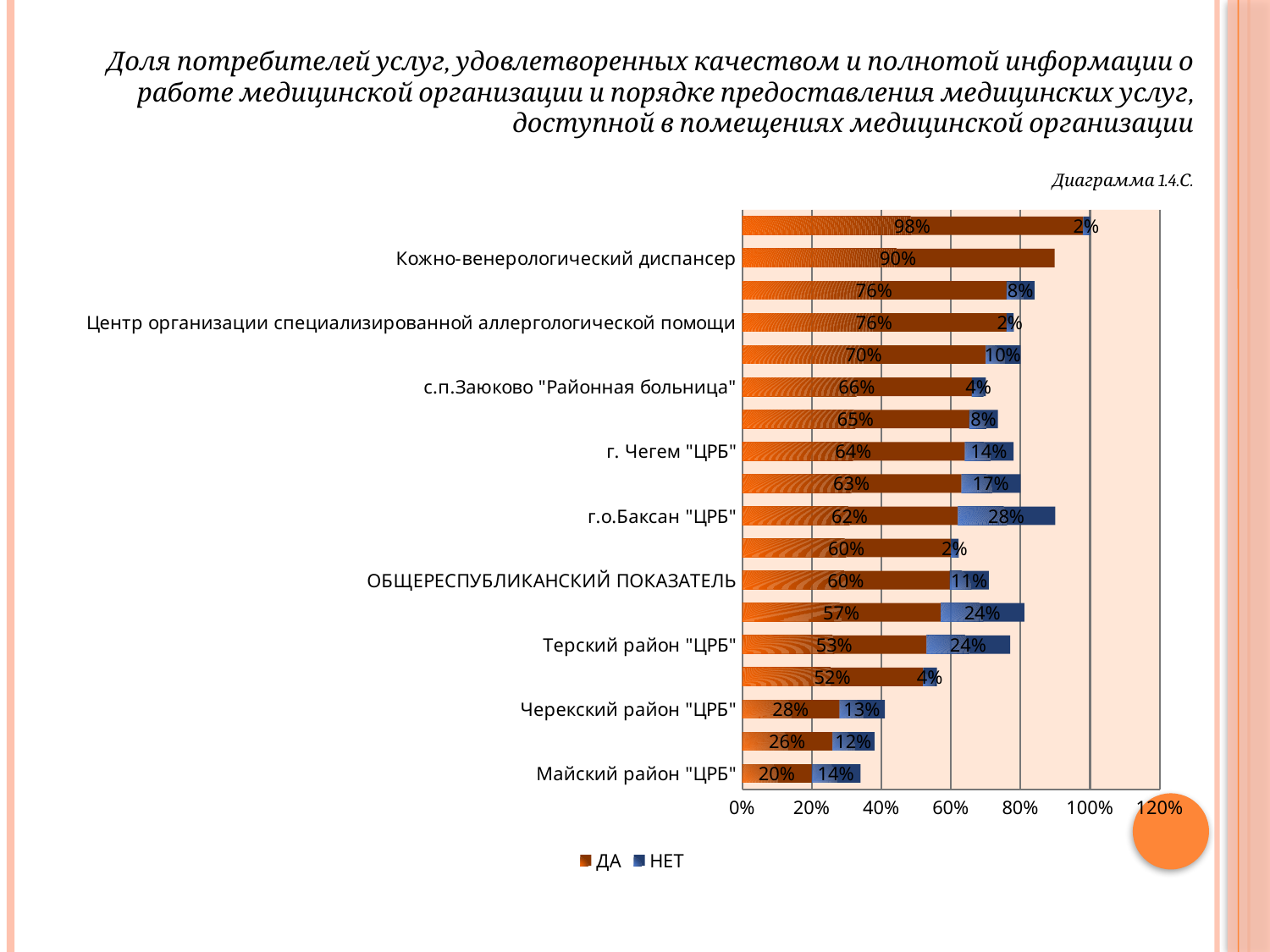
What kind of chart is shown on the slide? bar chart What is the ДА value for г. Чегем "ЦРБ"? 64% How many series does the legend list? 2 What is the total of the ДА and НЕТ values for г.о.Баксан "ЦРБ"? 90% Which has a higher ДА value: Терский район "ЦРБ" or Черекский район "ЦРБ"? Терский район "ЦРБ" What are the two legend entries of the chart? ДА and НЕТ What is the ДА value for Майский район "ЦРБ"? 20% What is the НЕТ value for Терский район "ЦРБ"? 24% What is the НЕТ value for г.о.Баксан "ЦРБ"? 28% Which of the labelled categories has the lowest ДА value? Майский район "ЦРБ" What is the ДА value for ОБЩЕРЕСПУБЛИКАНСКИЙ ПОКАЗАТЕЛЬ? 60% What is the highest ДА value shown on the chart? 98%